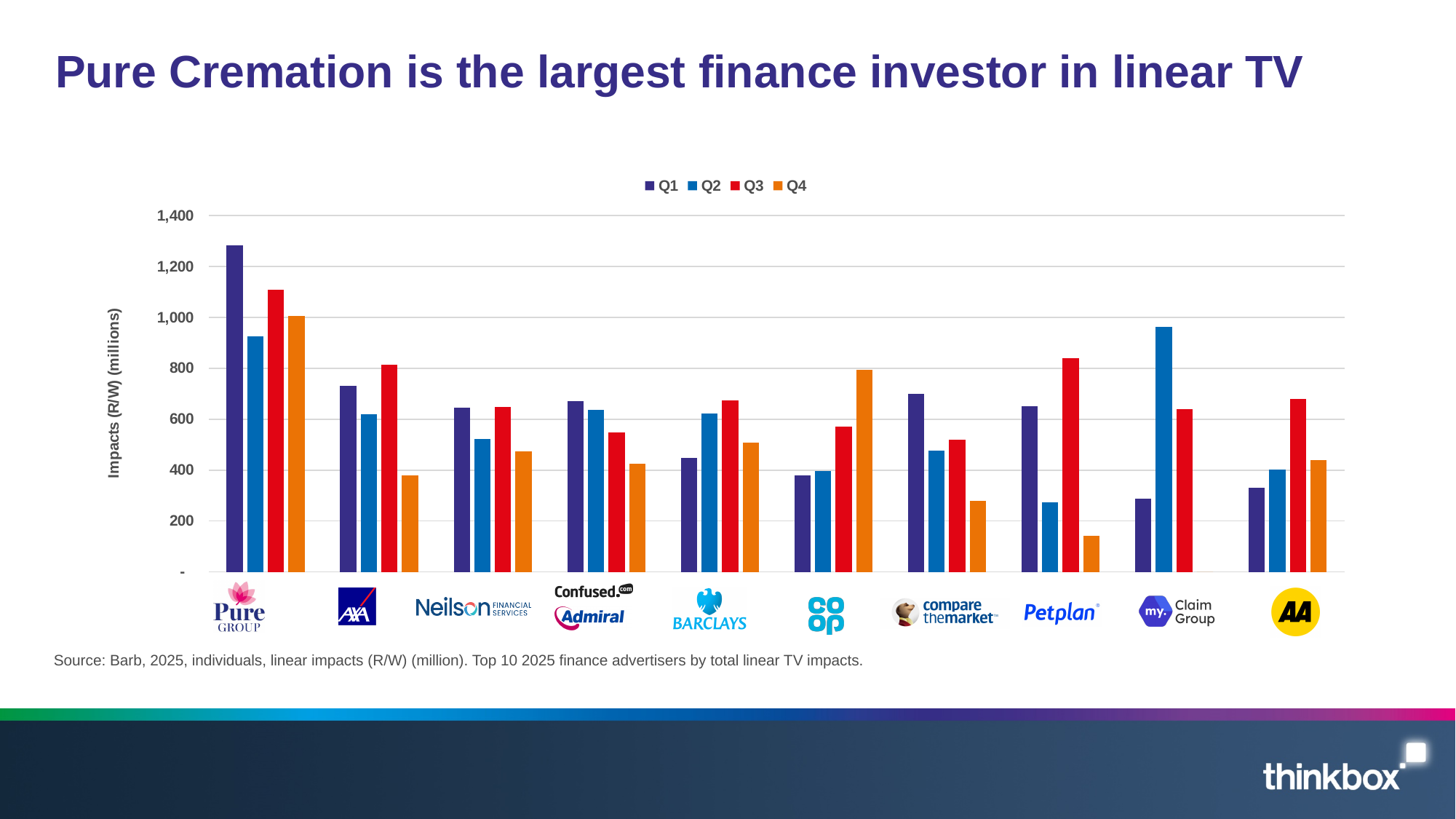
Is the Q2 value for My Claim Group greater or less than 800? greater Which quarter has the highest value for My Claim Group? Q2 Is the Q4 value for Petplan greater or less than 200? less Which quarter has the lowest value for Petplan? Q4 Is the Q1 value for Pure Group greater or less than 1,200? greater Do the values for Co-op rise or fall from Q1 to Q4? rise How many series does the legend list? 4 Which advertiser has the highest Q1 value? Pure Group Which advertiser has the highest Q4 value? Pure Group How many advertisers are shown on the x axis? 10 What kind of chart is shown on the slide? Bar chart